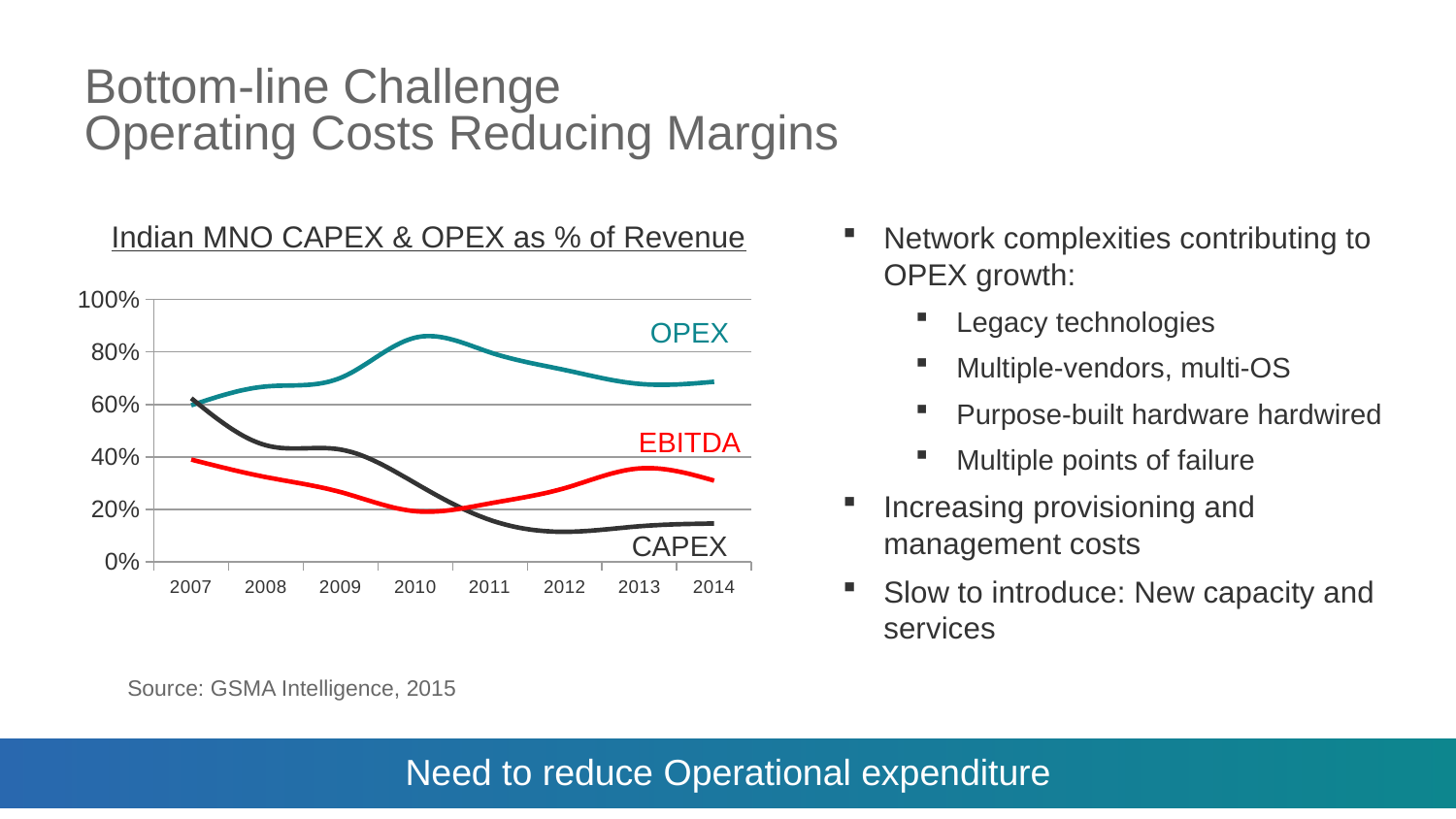
In 2008, which is larger, CAPEX or EBITDA? CAPEX How many series are plotted in the chart? 3 In 2014, which is larger, OPEX or CAPEX? OPEX What is the title of the chart? Indian MNO CAPEX & OPEX as % of Revenue What kind of chart is shown on the slide? line chart In which year does EBITDA reach its lowest value? 2010 Is the OPEX value for 2010 greater or less than 80%? greater Is the CAPEX value for 2012 greater or less than 20%? less Is the EBITDA value for 2013 greater or less than 40%? less How many years are shown on the x axis of the chart? 8 Does CAPEX rise or fall from 2007 to 2012? fall In which year does OPEX reach its highest value? 2010